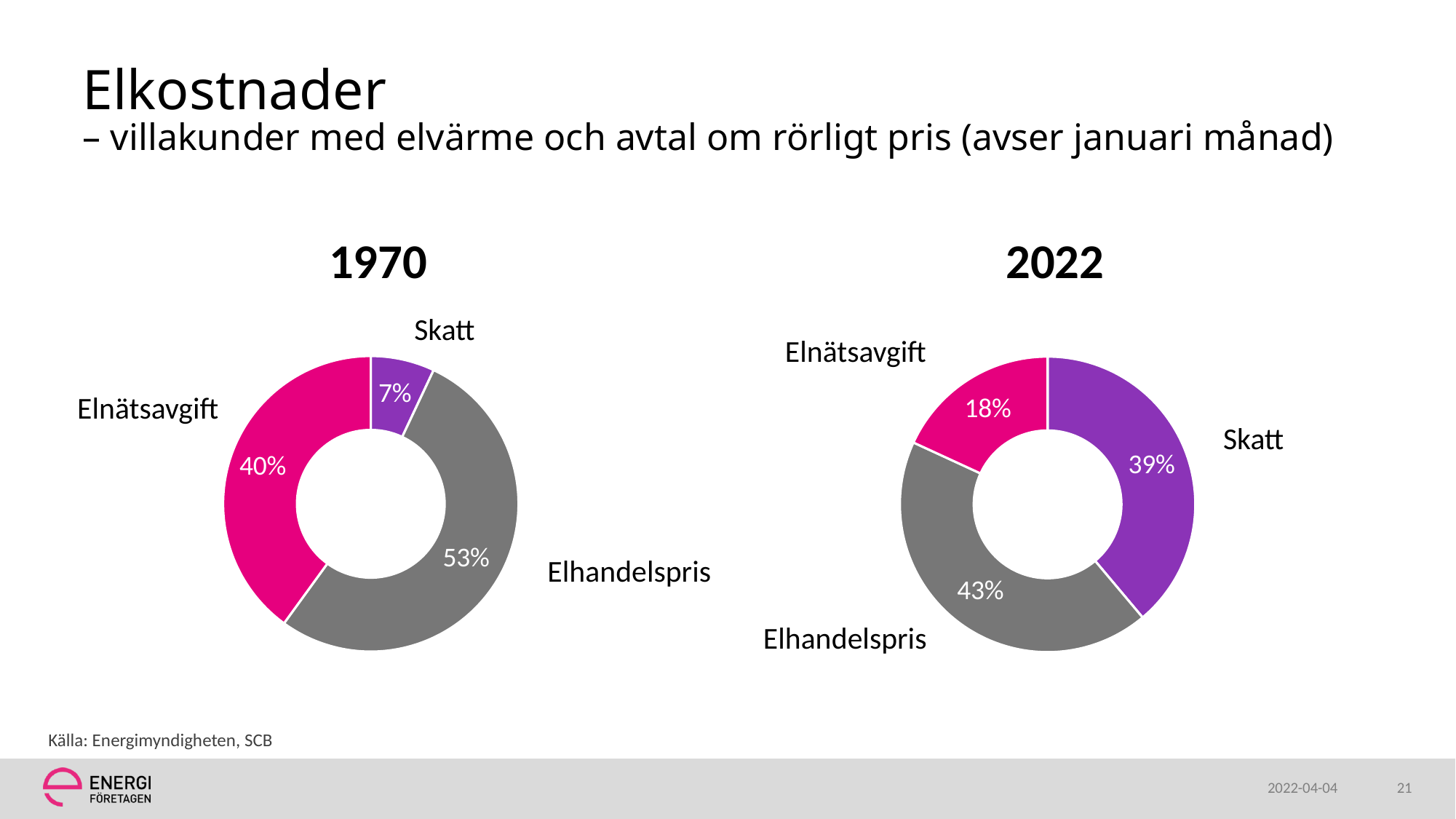
In the 1970 chart, what share is Skatt? 7% Which is larger in the 2022 chart: Skatt or Elnätsavgift? Skatt In the 1970 chart, which category has the smallest share? Skatt In the 2022 chart, which category has the smallest share? Elnätsavgift In the 1970 chart, what share is Elhandelspris? 53% In the 2022 chart, what is the difference between the Elhandelspris share and the Skatt share? 4 percentage points In the 1970 chart, which category has the largest share? Elhandelspris How many categories does the 2022 chart show? 3 In the 1970 chart, what is the difference between the Elnätsavgift share and the Skatt share? 33 percentage points What type of chart is the 1970 chart? Doughnut (pie) chart In the 2022 chart, what share is Elnätsavgift? 18% In the 2022 chart, what share is Skatt? 39%